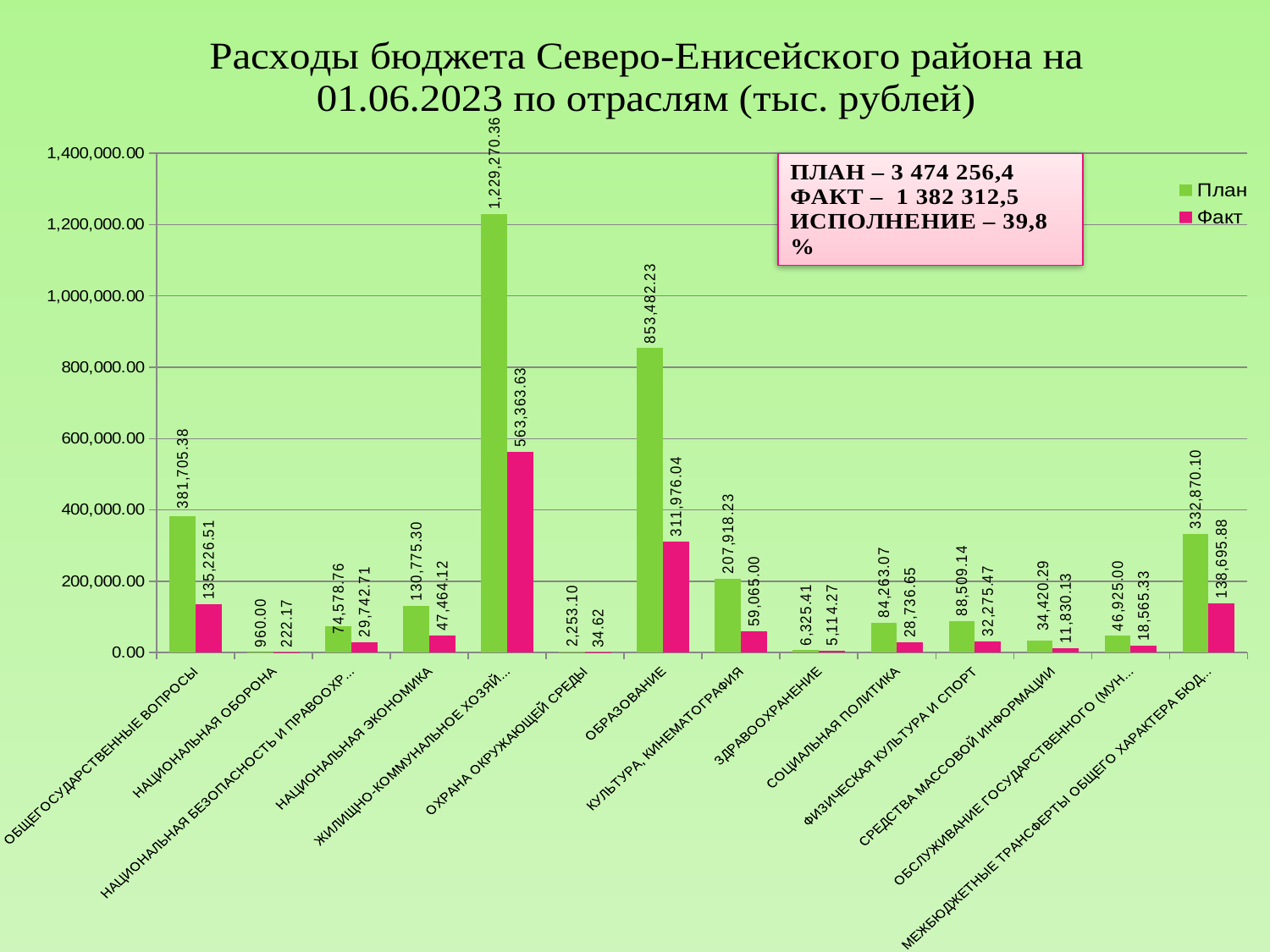
What is the difference between the План and Факт values for ОБРАЗОВАНИЕ? 541,506.19 What kind of chart is shown on the slide? bar chart What is the Факт value for НАЦИОНАЛЬНАЯ ЭКОНОМИКА? 47,464.12 What is the План value for ОБРАЗОВАНИЕ? 853,482.23 Which category has the highest План value? ЖИЛИЩНО-КОММУНАЛЬНОЕ ХОЗЯЙ... Which has the larger План value: ОБЩЕГОСУДАРСТВЕННЫЕ ВОПРОСЫ or МЕЖБЮДЖЕТНЫЕ ТРАНСФЕРТЫ ОБЩЕГО ХАРАКТЕРА БЮД...? ОБЩЕГОСУДАРСТВЕННЫЕ ВОПРОСЫ What is the ИСПОЛНЕНИЕ percentage shown in the text box on the chart? 39,8 % How many series does the legend list? 2 Which category has the lowest Факт value? ОХРАНА ОКРУЖАЮЩЕЙ СРЕДЫ What is the Факт value for ЖИЛИЩНО-КОММУНАЛЬНОЕ ХОЗЯЙ...? 563,363.63 Is the План value for ОБРАЗОВАНИЕ greater or less than 800,000.00? greater How many categories are shown on the x axis? 14